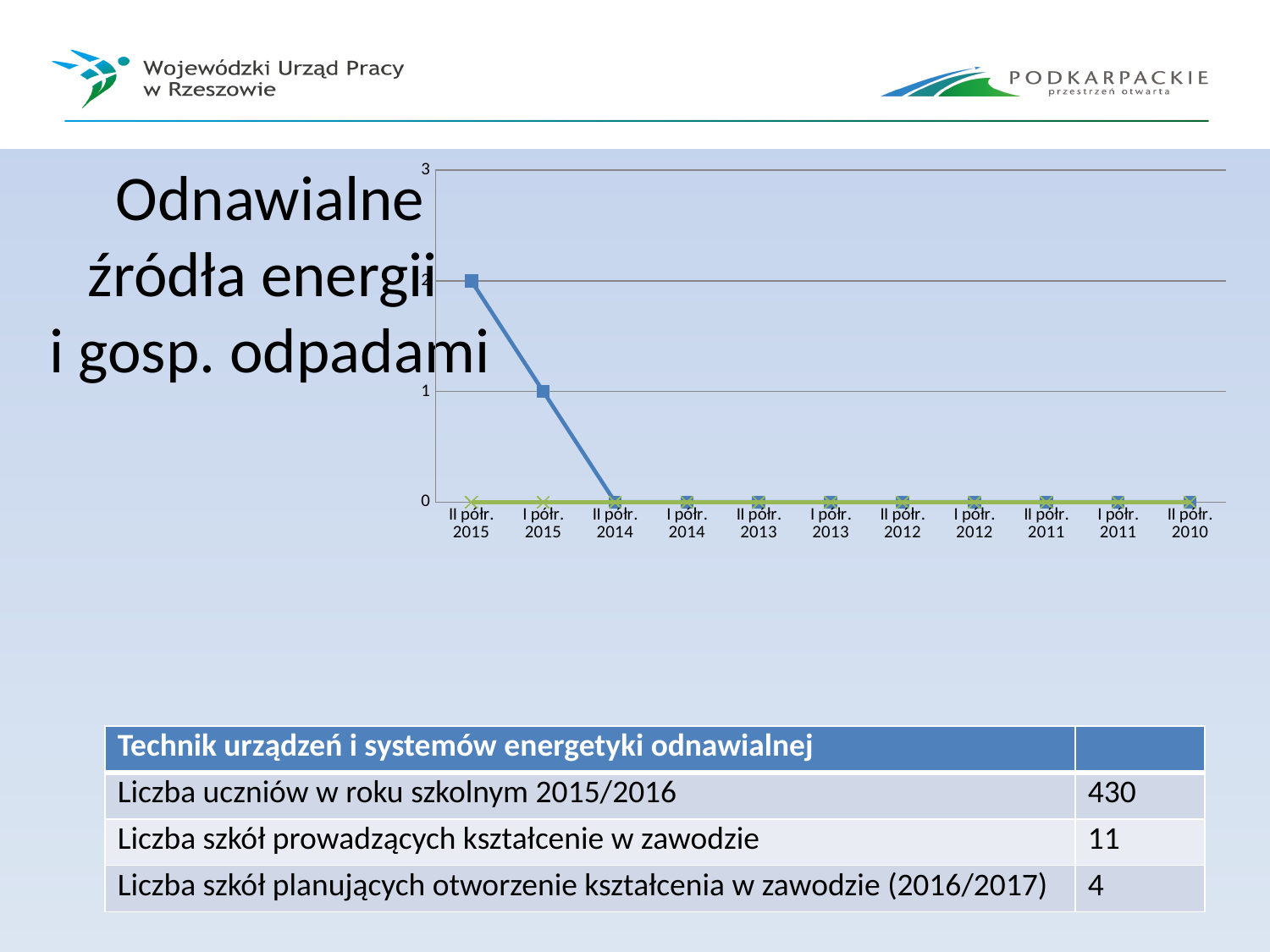
Which has the larger value on the blue line: II półr. 2015 or I półr. 2015? II półr. 2015 What is the value of the blue line at II półr. 2015? 2 What is the value of the blue line at II półr. 2014? 0 What is the highest tick value shown on the y axis? 3 What kind of chart is shown on the slide? line chart At which category does the blue line reach its highest value? II półr. 2015 Does the blue line rise or fall from left to right along the x axis? fall What is the difference between the blue line's values at II półr. 2015 and I półr. 2015? 1 What is the value of the green line at II półr. 2015? 0 Is the value of the blue line at II półr. 2015 greater or less than 1? greater What is the value of the blue line at I półr. 2015? 1 How many categories are shown on the x axis of the chart? 11